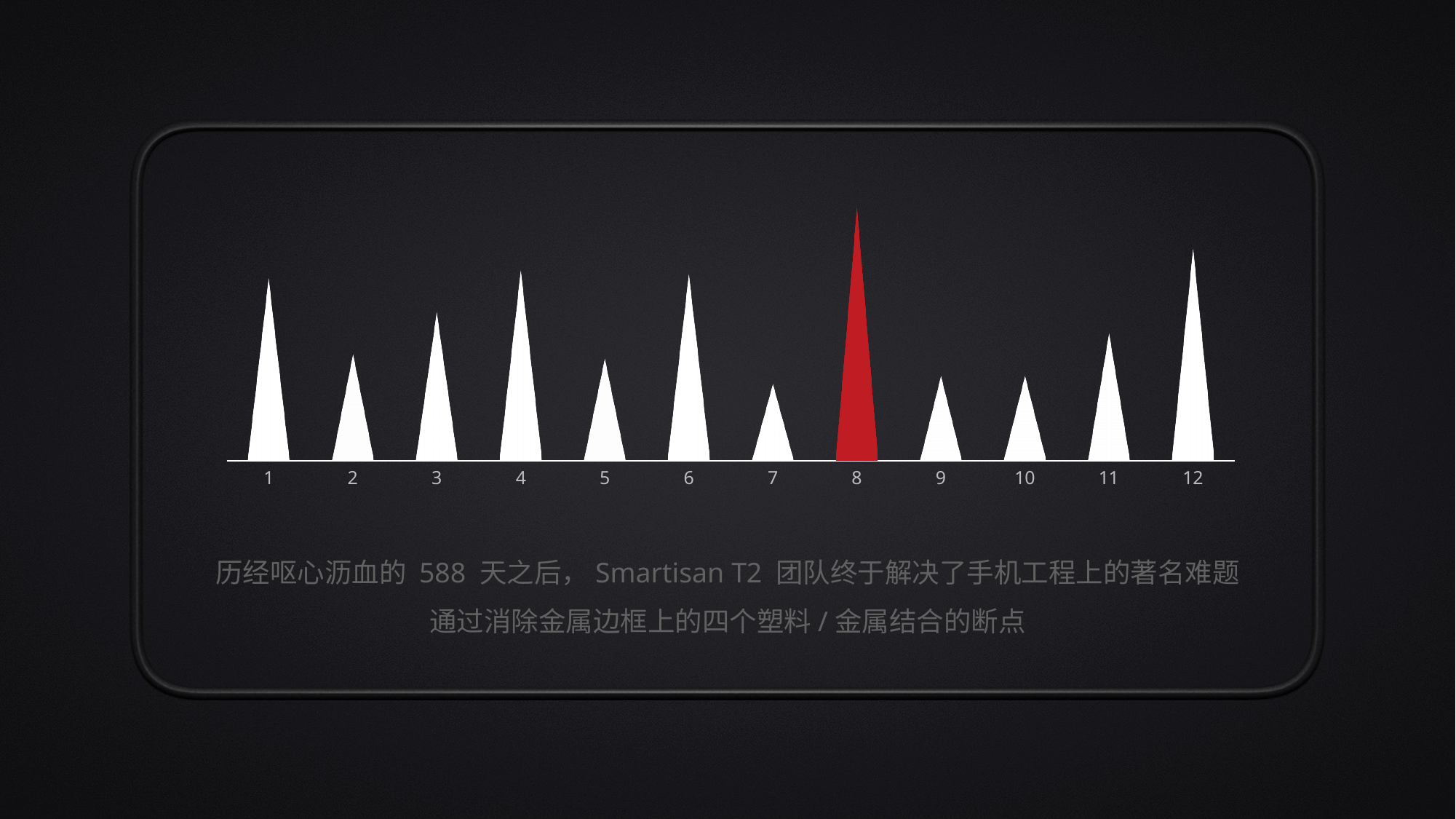
Which is larger in the chart, the value for category 1 or category 2? 1 Which is larger in the chart, the value for category 8 or category 12? 8 Which is larger in the chart, the value for category 3 or category 9? 3 Which category is highlighted in red in the chart? 8 How many categories are shown along the x axis of the chart? 12 Which category has the highest value in the chart? 8 What is the label of the first category on the x axis of the chart? 1